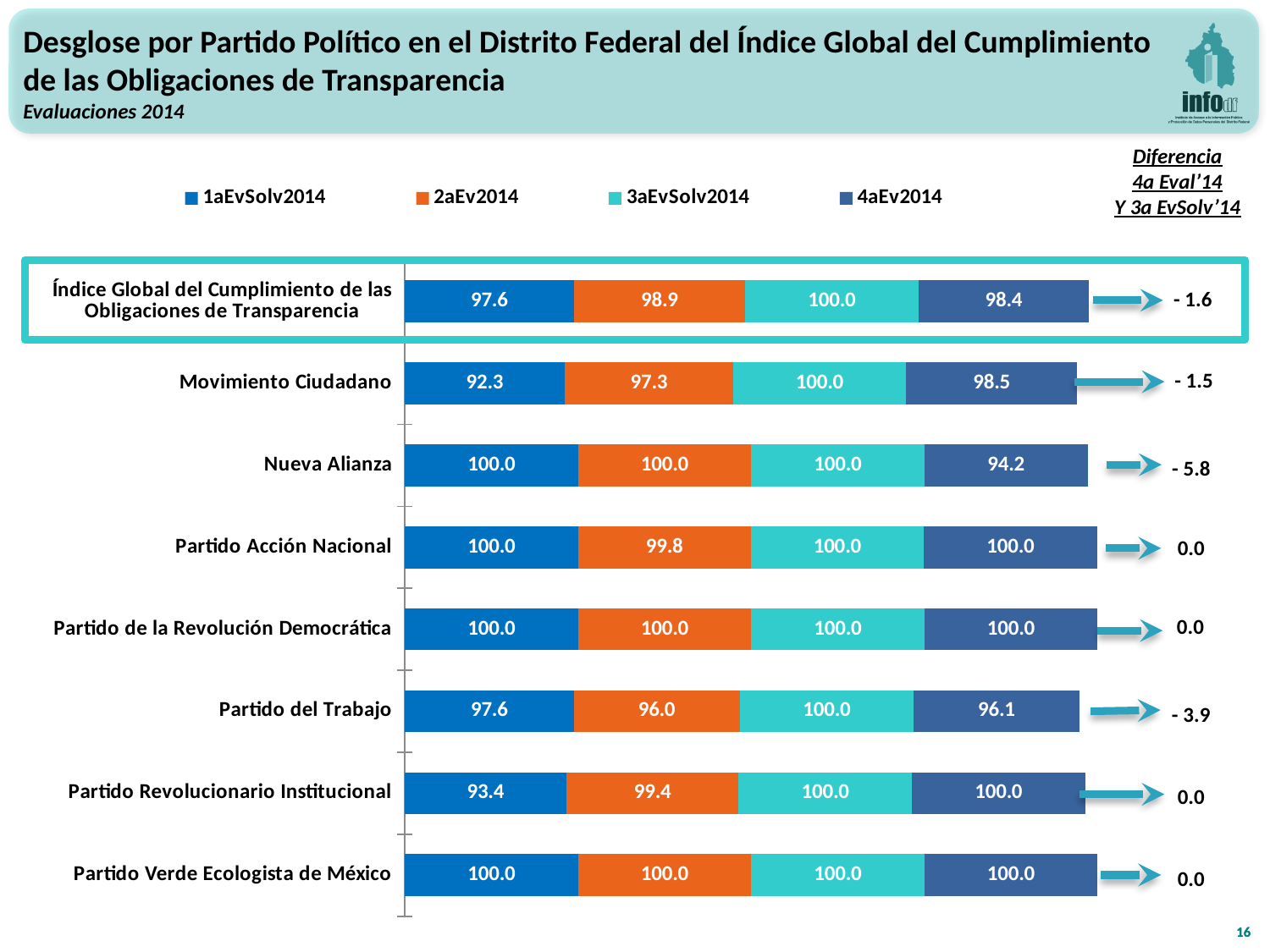
Which category has the lowest 1aEvSolv2014 value? Movimiento Ciudadano How many categories are shown on the chart? 8 Which is larger: the 1aEvSolv2014 value for Partido Revolucionario Institucional or for Movimiento Ciudadano? Partido Revolucionario Institucional What is the 4aEv2014 value for Nueva Alianza? 94.2 What is the total of the stacked bar for Partido del Trabajo? 389.7 What is the difference between the 4aEv2014 and 1aEvSolv2014 values for Movimiento Ciudadano? 6.2 How many series does the legend list? 4 What is the 1aEvSolv2014 value for Movimiento Ciudadano? 92.3 What kind of chart is shown on the slide? Stacked bar chart Which category has the lowest 4aEv2014 value? Nueva Alianza What is the 1aEvSolv2014 value for Partido Revolucionario Institucional? 93.4 What is the 2aEv2014 value for Partido del Trabajo? 96.0